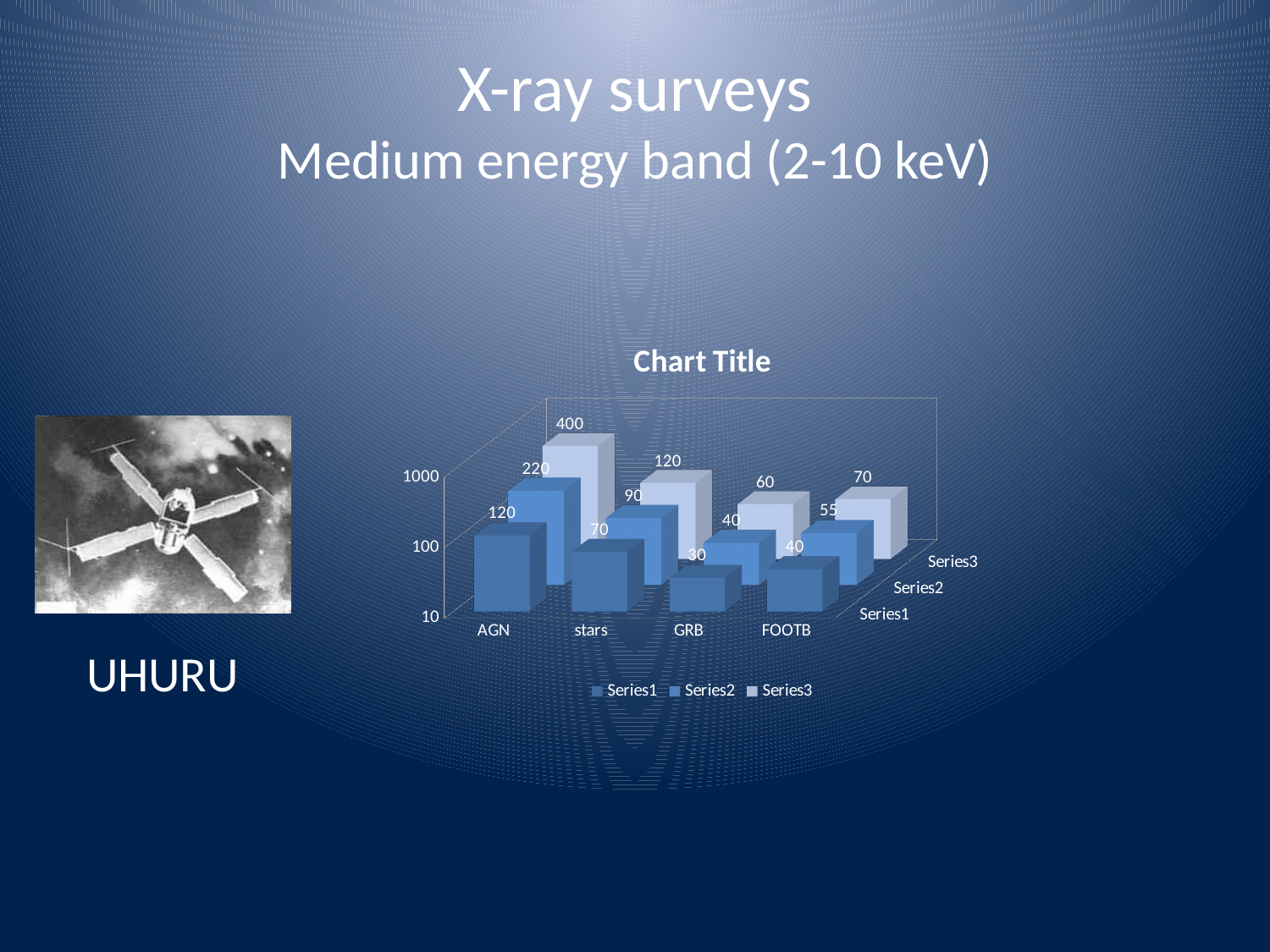
What is the value for AGN in Series3? 400 What is the value for FOOTB in Series2? 55 What is the value for stars in Series2? 90 What is the difference between the Series3 value for AGN and the Series3 value for stars? 280 Which category has the highest value in Series3? AGN What kind of chart is shown on the slide? Bar chart What is the value for AGN in Series1? 120 What is the value for GRB in Series1? 30 Which is larger: the Series2 value for GRB or the Series2 value for FOOTB? FOOTB How many categories are shown on the x axis? 4 How many series does the legend list? 3 Which category has the lowest value in Series1? GRB